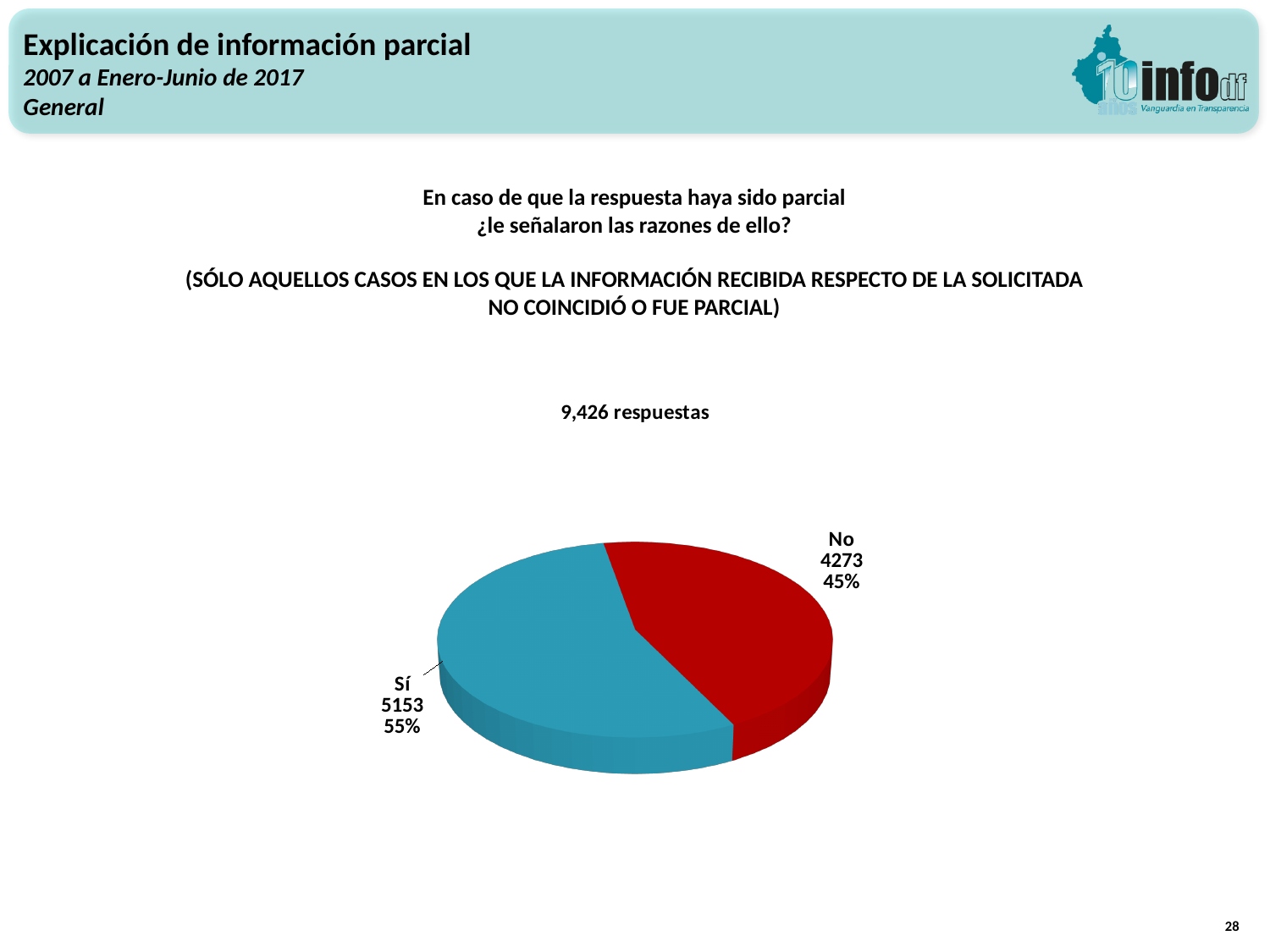
Which is larger, the value for "Sí" or the value for "No"? Sí What percentage share does the "No" slice represent? 45% What percentage share does the "Sí" slice represent? 55% How many slices does the pie chart have? 2 What is the difference between the values for "Sí" and "No"? 880 Which category has the largest slice in the pie chart? Sí What colour is the "No" slice in the pie chart? red What is the value for "No" in the pie chart? 4273 How many total responses does the slide report for the chart? 9,426 respuestas What is the value for "Sí" in the pie chart? 5153 Which category has the smallest slice in the pie chart? No What kind of chart is shown on the slide? pie chart